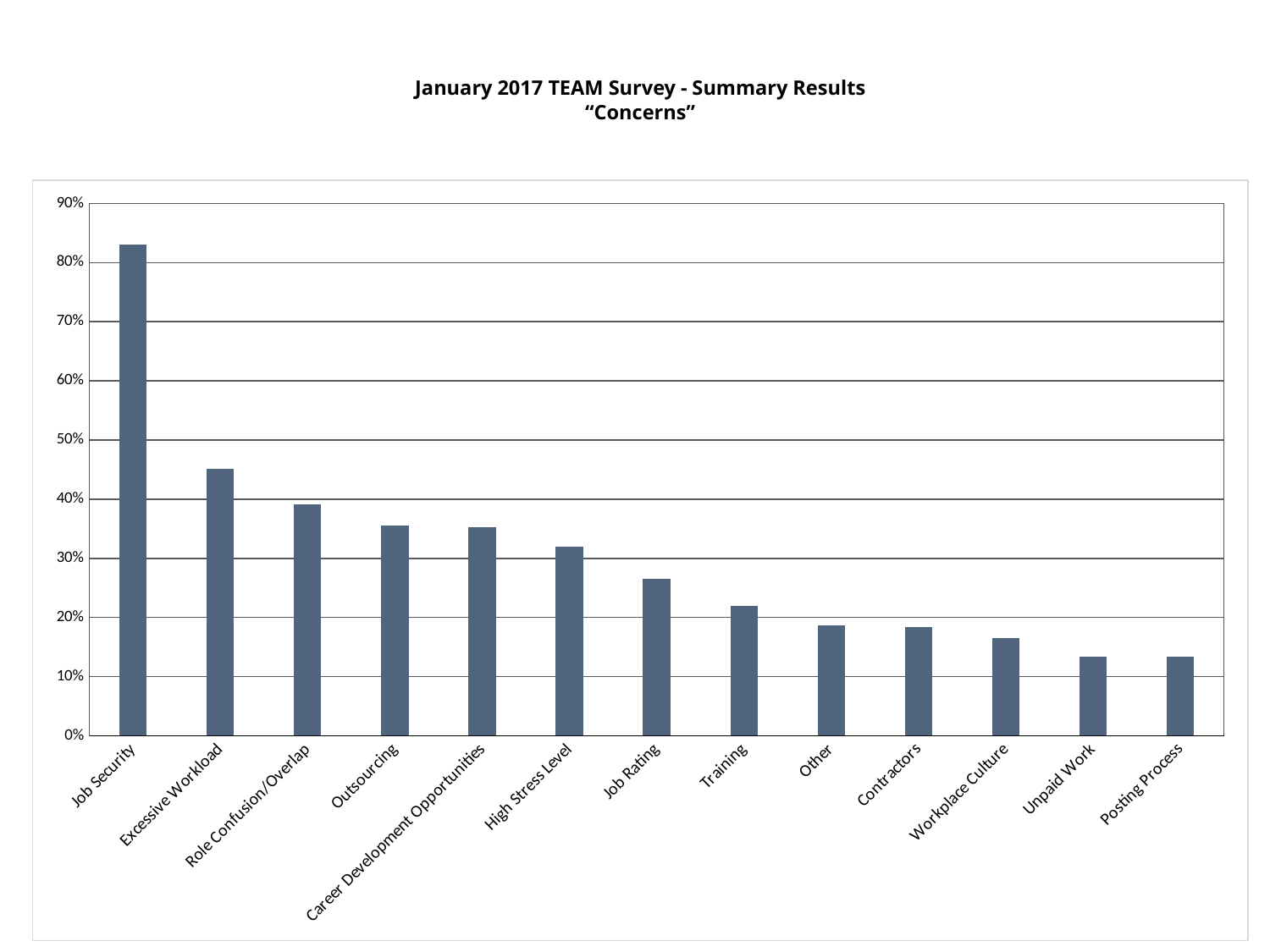
Is the value for Job Security greater or less than 80%? greater Is the value for Excessive Workload greater or less than 50%? less Which is larger, the value for High Stress Level or the value for Job Rating? High Stress Level Do the values generally rise or fall moving from left to right along the x axis? fall How many concern categories are plotted on the chart? 13 What is the title of the chart? January 2017 TEAM Survey - Summary Results “Concerns” Which concern has the highest value? Job Security Is the value for Posting Process greater or less than 10%? greater What kind of chart is shown on the slide? bar chart